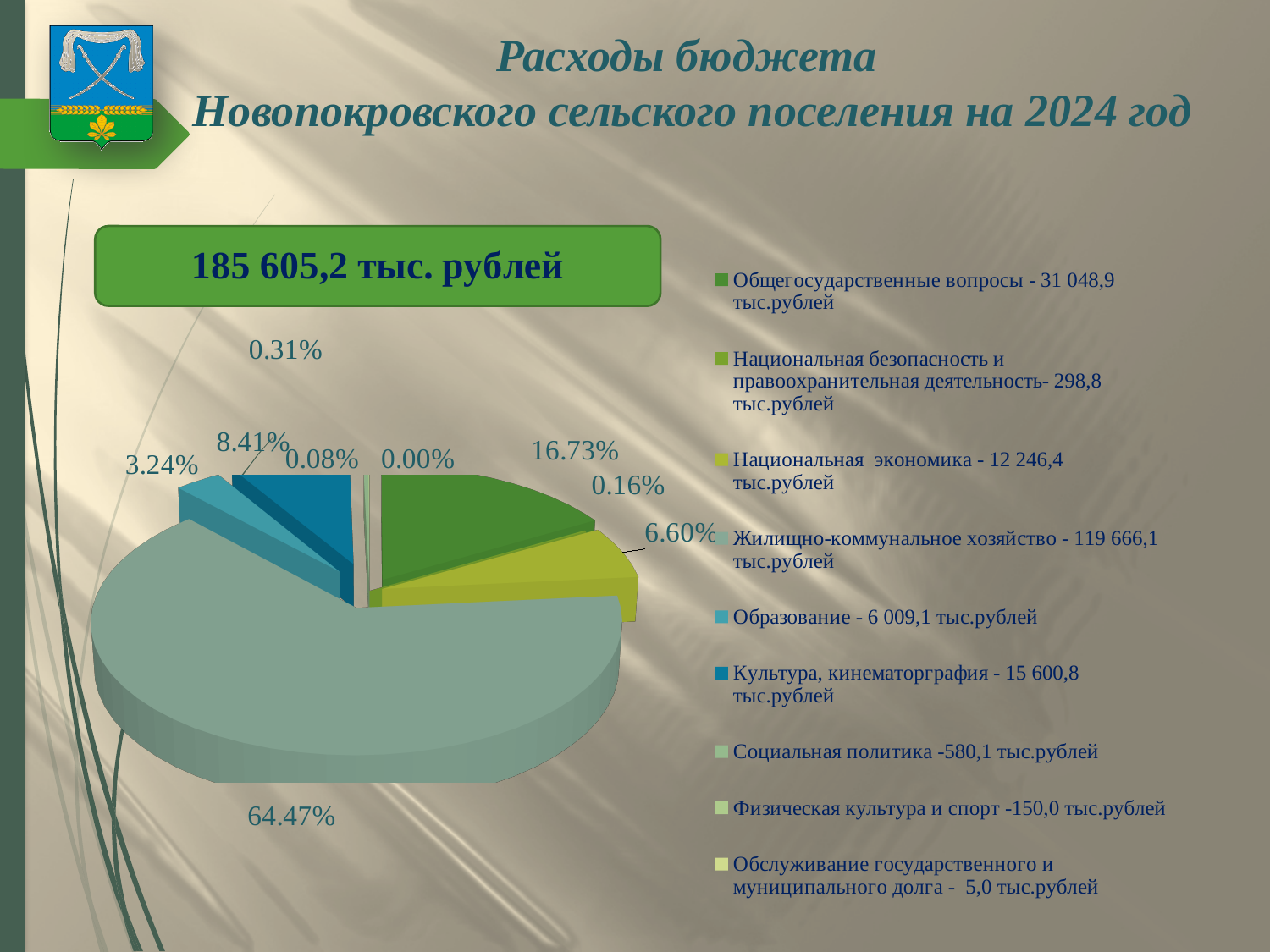
Which category has the smallest share of the pie chart? Обслуживание государственного и муниципального долга What amount is given in the legend for Образование? 6 009,1 тыс.рублей What amount is given in the legend for Культура, кинематорграфия? 15 600,8 тыс.рублей What is the total budget expenditure shown above the pie chart? 185 605,2 тыс. рублей Which category has the largest share of the pie chart? Жилищно-коммунальное хозяйство What is the title of the slide containing the pie chart? Расходы бюджета Новопокровского сельского поселения на 2024 год Which is larger: the amount for Общегосударственные вопросы or for Национальная экономика? Общегосударственные вопросы What amount is given in the legend for Общегосударственные вопросы? 31 048,9 тыс.рублей What kind of chart is shown on the slide? pie chart What amount is given in the legend for Жилищно-коммунальное хозяйство? 119 666,1 тыс.рублей What percentage share does the largest slice of the pie chart have? 64.47% How many categories does the legend of the pie chart list? 9